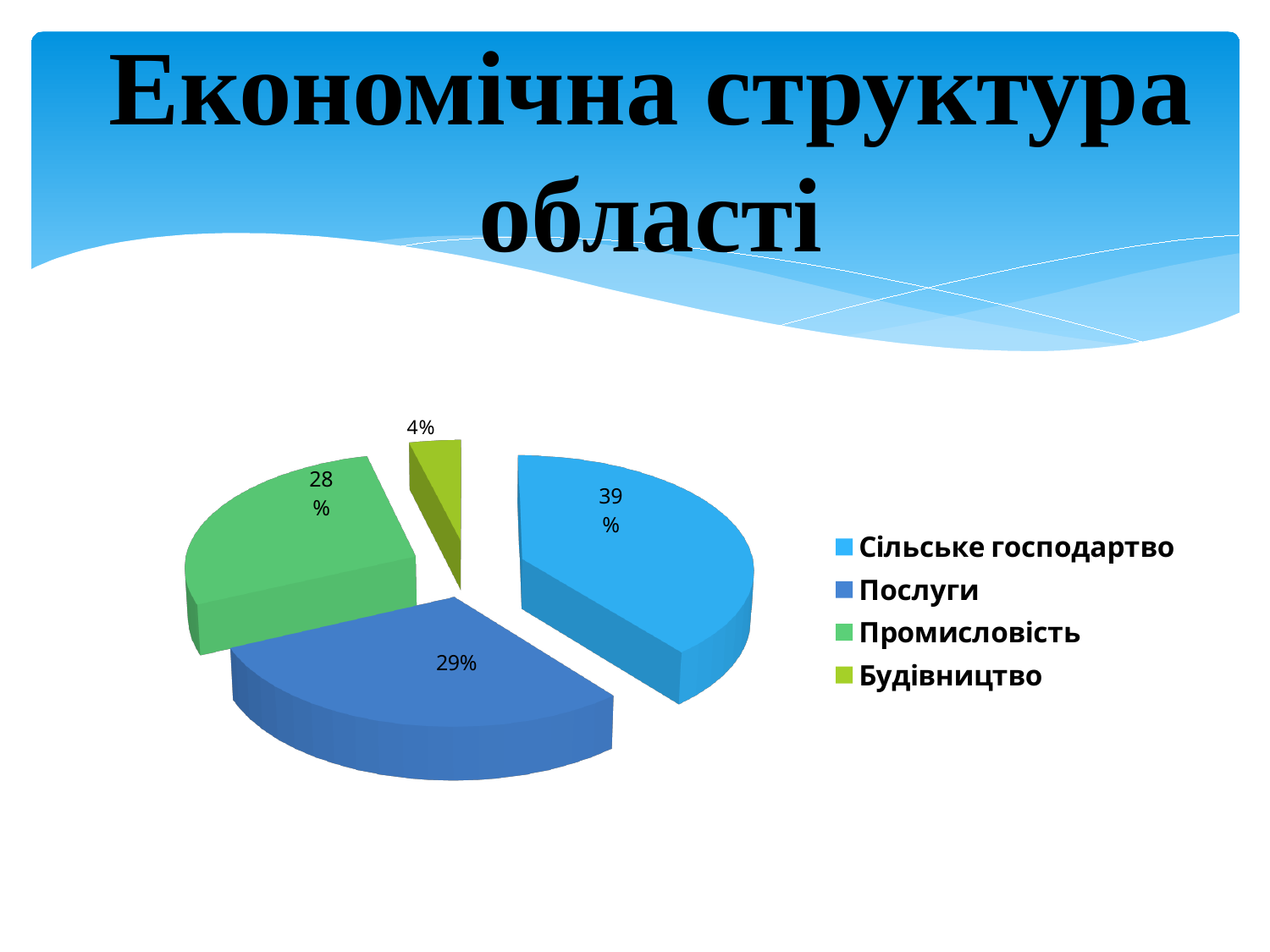
How many slices does the pie chart have? 4 What is the difference in percentage points between Сільське господартво and Послуги? 10 Which category has the largest slice of the pie? Сільське господартво What colour is the slice for Будівництво? yellow-green What share of the pie does Послуги have? 29% Which category has the smallest slice of the pie? Будівництво Which is larger, the share for Послуги or the share for Промисловість? Послуги What share of the pie does Сільське господартво have? 39% What share of the pie does Будівництво have? 4% How many entries does the legend list? 4 What share of the pie does Промисловість have? 28% What kind of chart is shown on the slide? pie chart